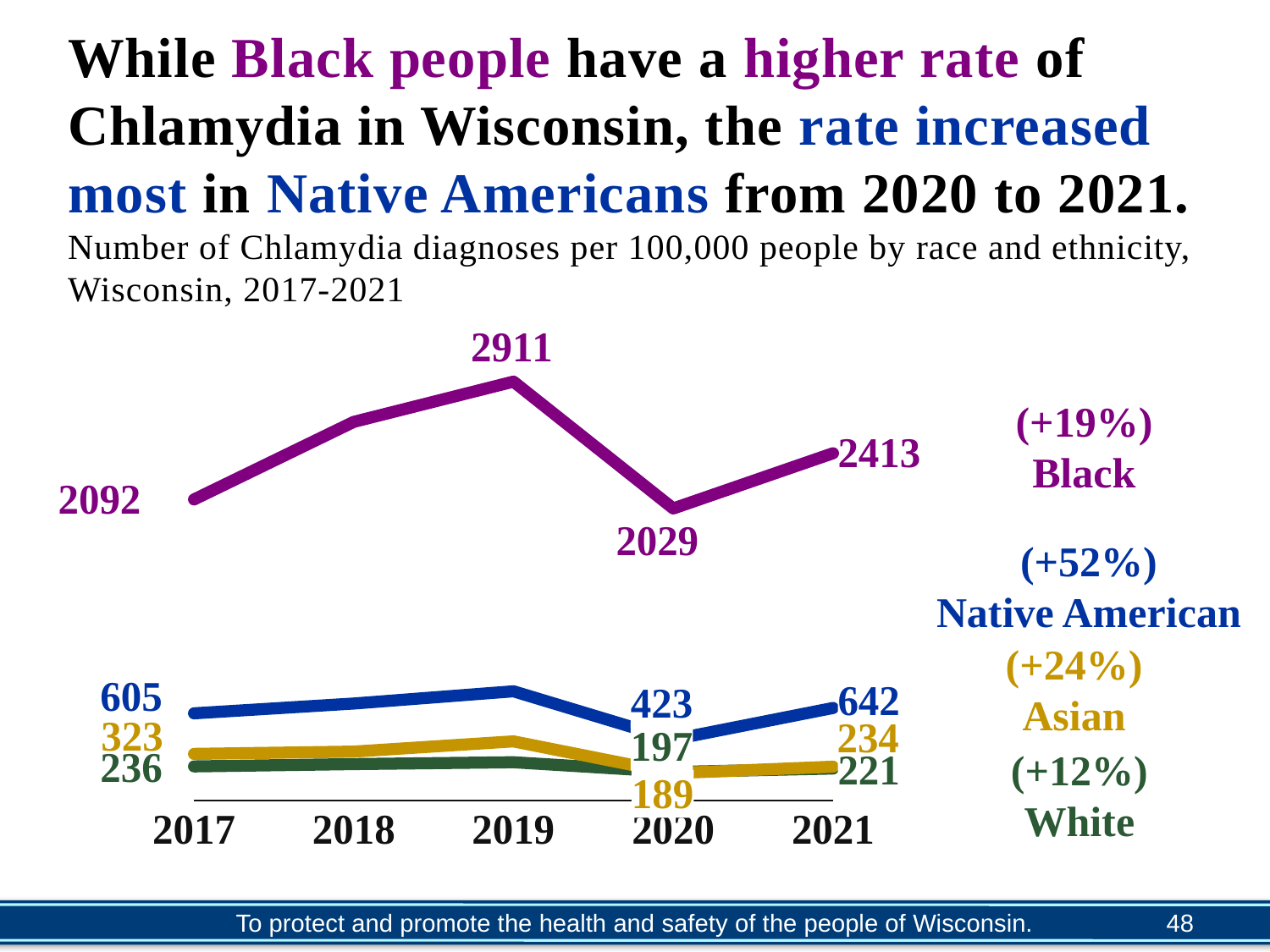
Was the Native American Chlamydia rate higher in 2017 or in 2021? 2021 By how much did the Chlamydia rate for Native Americans increase from 2020 to 2021? 219 In which year was the Chlamydia rate for Black people highest? 2019 What was the Chlamydia rate per 100,000 for Asian people in 2017? 323 What percentage increase from 2020 to 2021 is shown for Native Americans? +52% What type of chart is shown on the slide? Line chart How many race/ethnicity groups are plotted as lines in the chart? 4 How many years are shown on the x axis of the chart? 5 What was the Chlamydia rate per 100,000 for Native Americans in 2021? 642 By how much did the Chlamydia rate for Black people increase from 2020 to 2021? 384 What was the Chlamydia rate per 100,000 for Black people in 2020? 2029 What was the Chlamydia rate per 100,000 for Black people in Wisconsin in 2019? 2911